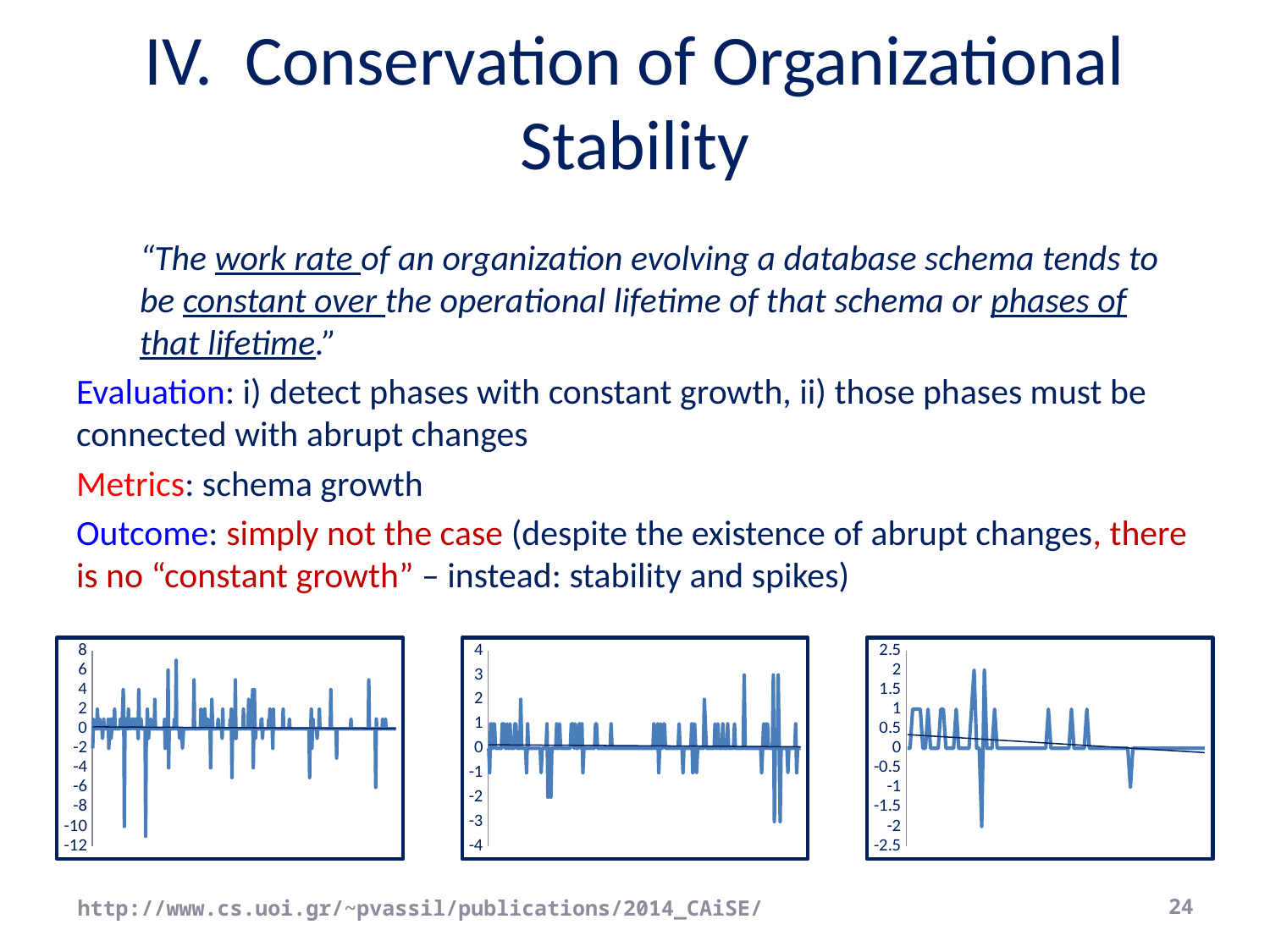
What kind of chart is the left chart on the slide? line chart What is the highest tick value on the y axis of the left chart? 8 In the left chart, is the highest value greater or less than 6? greater What is the lowest tick value on the y axis of the right chart? -2.5 In the left chart, is the lowest value greater or less than -10? less In the right chart, is the highest value greater or less than 1.5? greater How many charts are shown on the slide? 3 In the right chart, does the straight trend line slope upward or downward from left to right? downward What kind of chart is the right chart on the slide? line chart